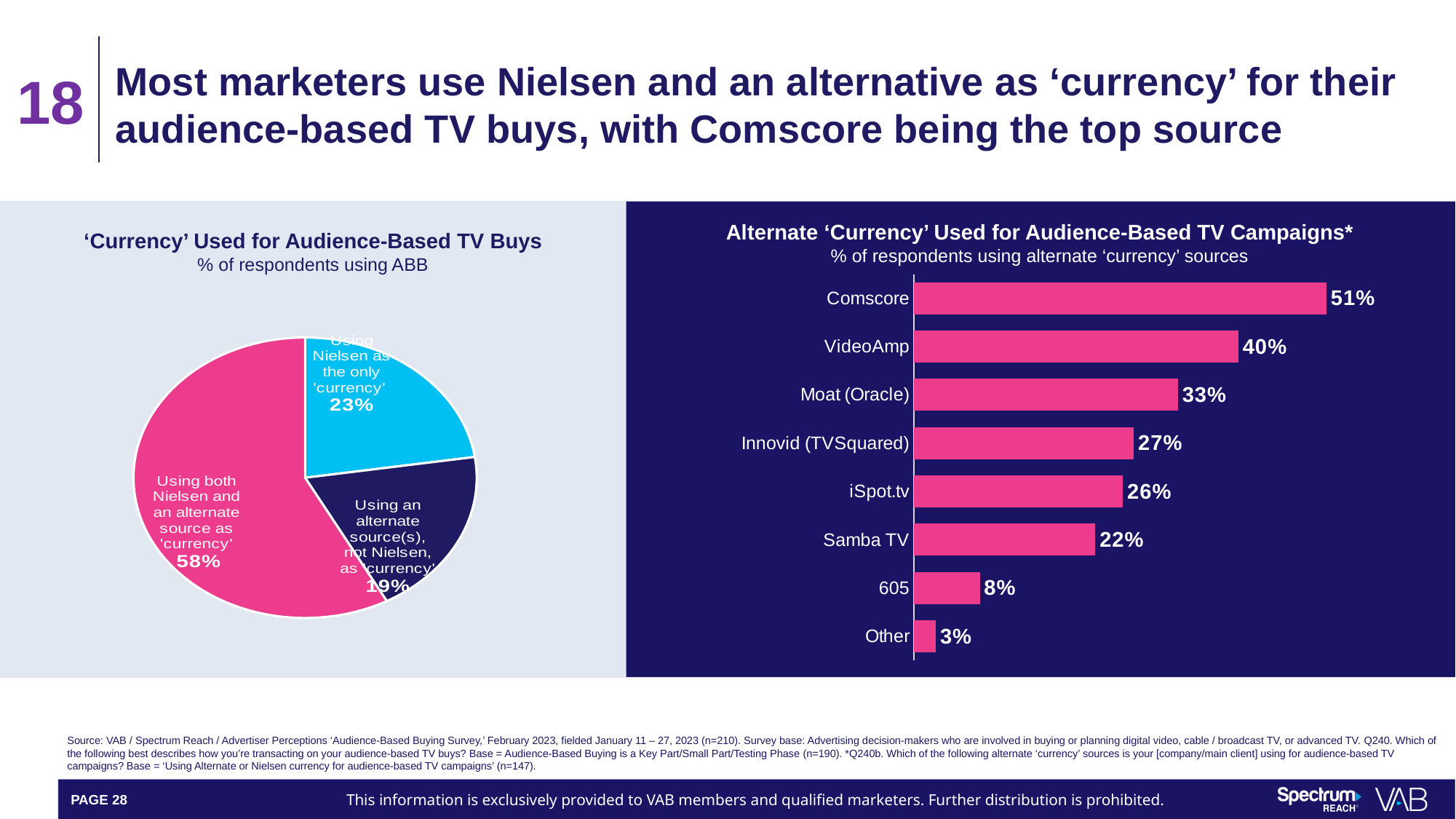
In the 'Currency' Used for Audience-Based TV Buys chart, what share of respondents are using Nielsen as the only 'currency'? 23% In the Alternate 'Currency' Used for Audience-Based TV Campaigns chart, what is the difference between Comscore and VideoAmp? 11% In the Alternate 'Currency' Used for Audience-Based TV Campaigns chart, how many sources are listed? 8 What kind of chart is the 'Currency' Used for Audience-Based TV Buys chart? Pie chart In the Alternate 'Currency' Used for Audience-Based TV Campaigns chart, what is the value for Comscore? 51% In the 'Currency' Used for Audience-Based TV Buys chart, how many slices does the pie have? 3 In the Alternate 'Currency' Used for Audience-Based TV Campaigns chart, what is the value for Samba TV? 22% In the 'Currency' Used for Audience-Based TV Buys chart, what share of respondents are using an alternate source, not Nielsen, as 'currency'? 19% In the 'Currency' Used for Audience-Based TV Buys chart, what share of respondents are using both Nielsen and an alternate source as 'currency'? 58% In the Alternate 'Currency' Used for Audience-Based TV Campaigns chart, which source has the lowest value? Other In the Alternate 'Currency' Used for Audience-Based TV Campaigns chart, which is larger, Moat (Oracle) or iSpot.tv? Moat (Oracle) In the Alternate 'Currency' Used for Audience-Based TV Campaigns chart, which source has the highest value? Comscore